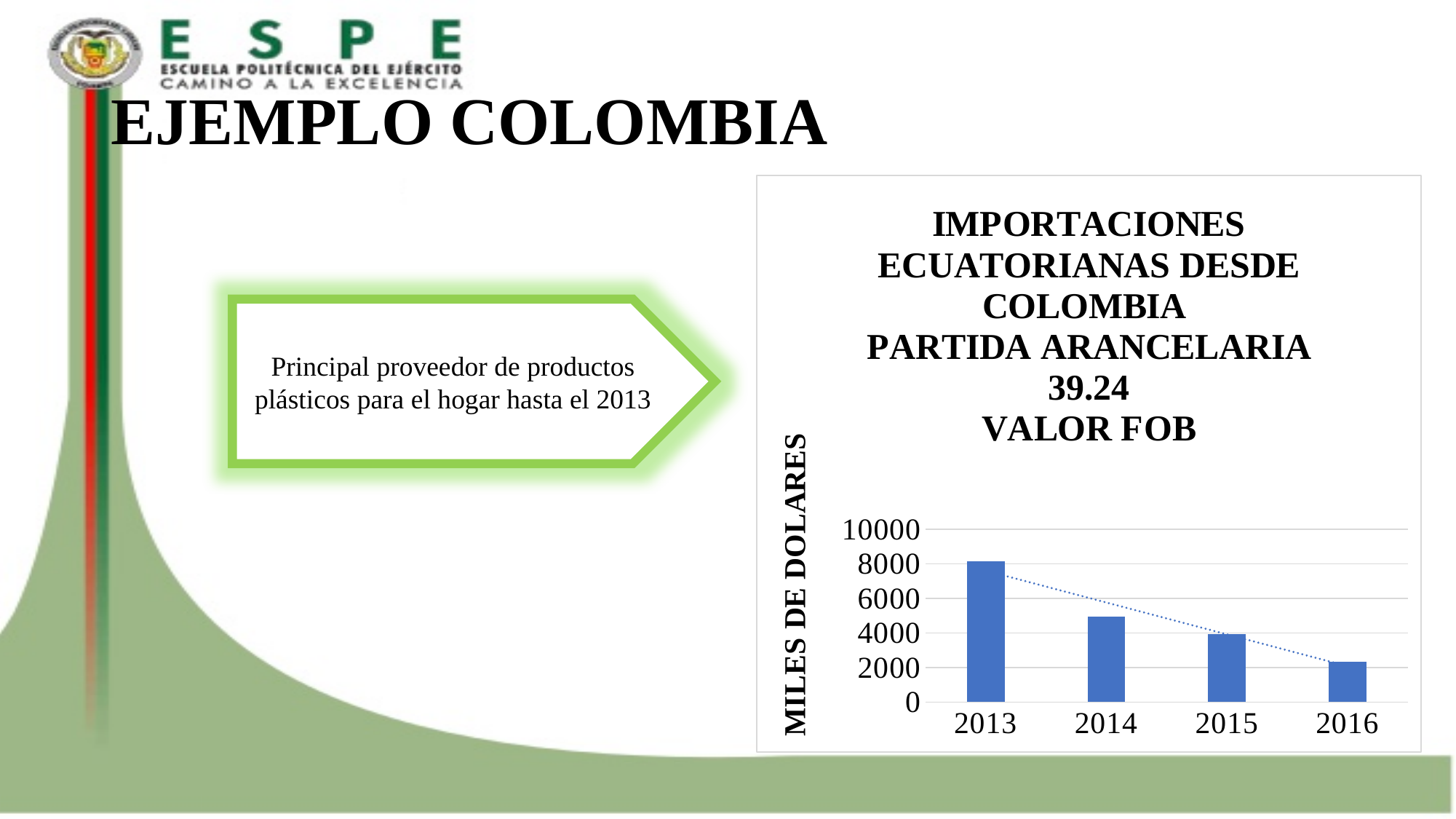
Is the value for 2013 greater or less than 6000? greater Which year has the larger value, 2013 or 2014? 2013 What is the label on the vertical axis of the chart? MILES DE DOLARES What kind of chart is shown on the slide? bar chart Which year has the highest value in the chart? 2013 How many years are shown on the x axis of the chart? 4 Which year has the larger value, 2015 or 2016? 2015 Is the value for 2014 greater or less than 6000? less Which year has the lowest value in the chart? 2016 Do the values rise or fall from 2013 to 2016? fall What is the highest tick value shown on the vertical axis of the chart? 10000 Is the value for 2016 greater or less than 4000? less